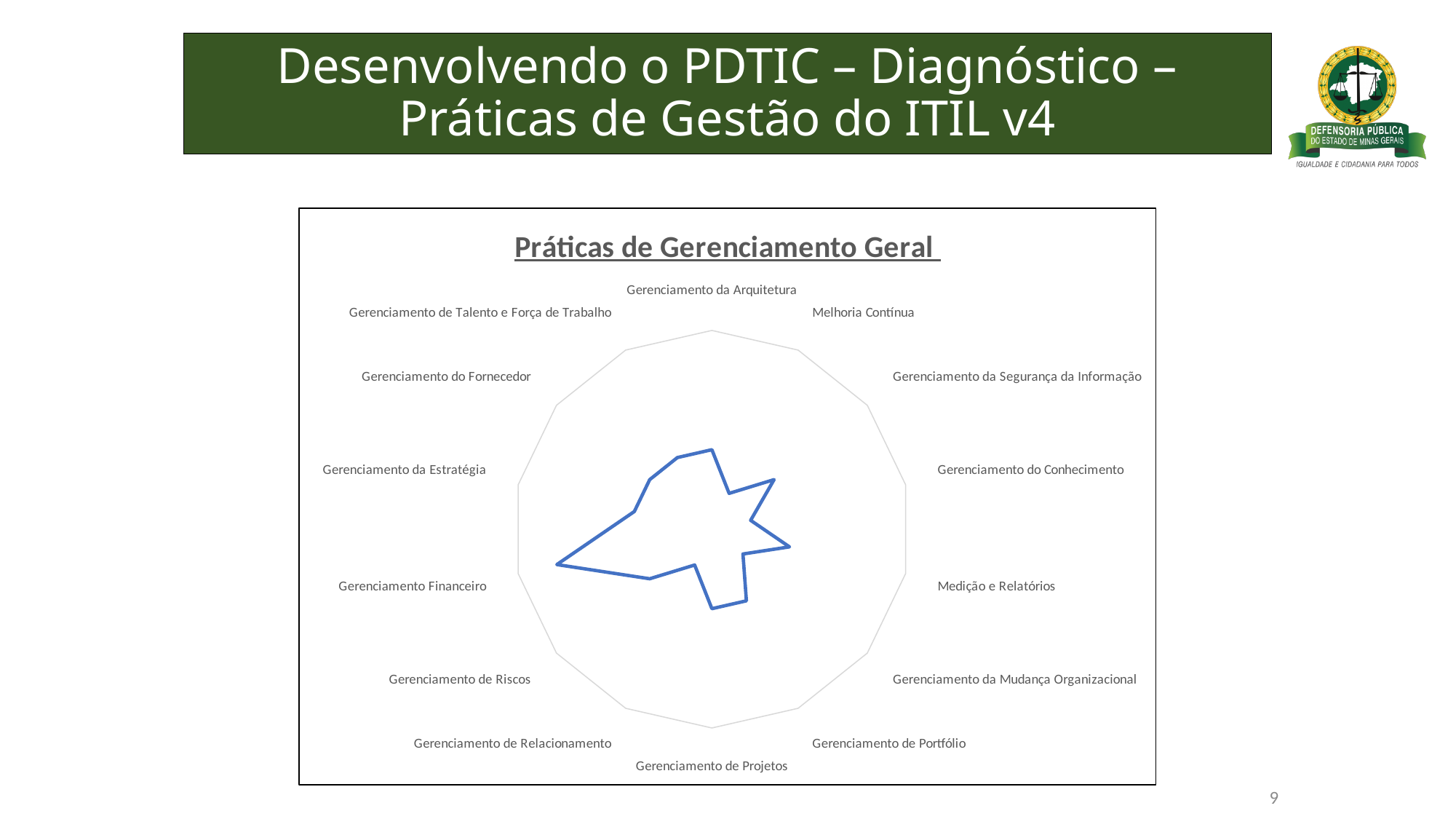
Which practice has the highest value on the radar chart? Gerenciamento Financeiro Which practice is labelled at the top of the radar chart? Gerenciamento da Arquitetura Which has the larger value, Gerenciamento Financeiro or Gerenciamento do Conhecimento? Gerenciamento Financeiro How many practices (categories) are plotted on the radar chart? 14 Which has the larger value, Gerenciamento da Segurança da Informação or Melhoria Contínua? Gerenciamento da Segurança da Informação What is the title of the chart? Práticas de Gerenciamento Geral What colour is the data line on the radar chart? Blue What kind of chart is shown on the slide? Radar chart Which has the larger value, Gerenciamento Financeiro or Gerenciamento da Estratégia? Gerenciamento Financeiro